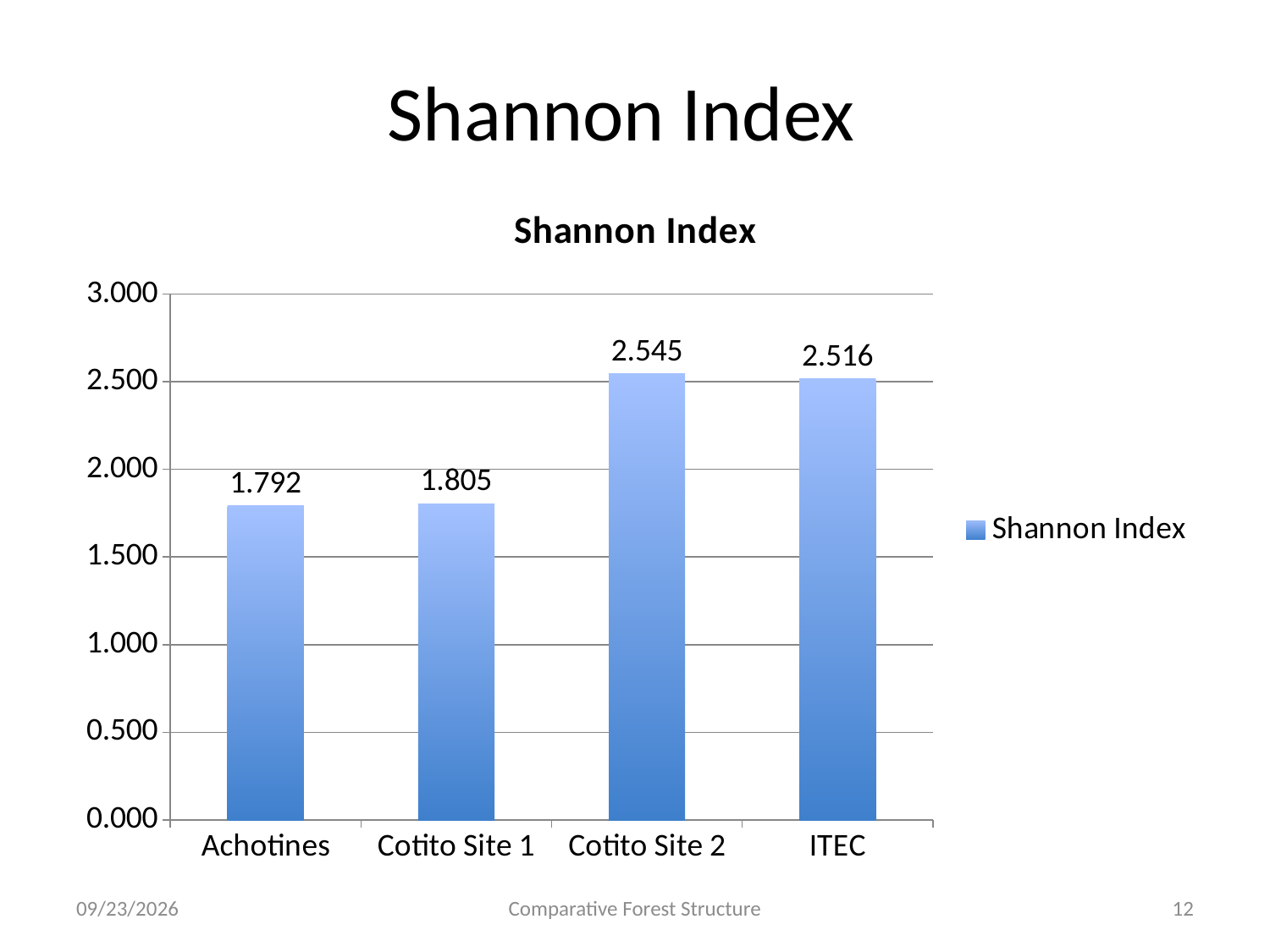
Which site has the highest Shannon Index? Cotito Site 2 How many sites are shown on the chart? 4 What is the difference between the Shannon Index values for Cotito Site 2 and Achotines? 0.753 Which has a larger Shannon Index, Cotito Site 1 or ITEC? ITEC What is the Shannon Index value for Achotines? 1.792 Which site has the lowest Shannon Index? Achotines What is the title of the chart? Shannon Index What is the Shannon Index value for ITEC? 2.516 Is the Shannon Index value for Cotito Site 1 greater or less than 2.000? less What is the difference between the Shannon Index values for Cotito Site 2 and ITEC? 0.029 What is the Shannon Index value for Cotito Site 2? 2.545 What kind of chart is shown on the slide? Bar chart